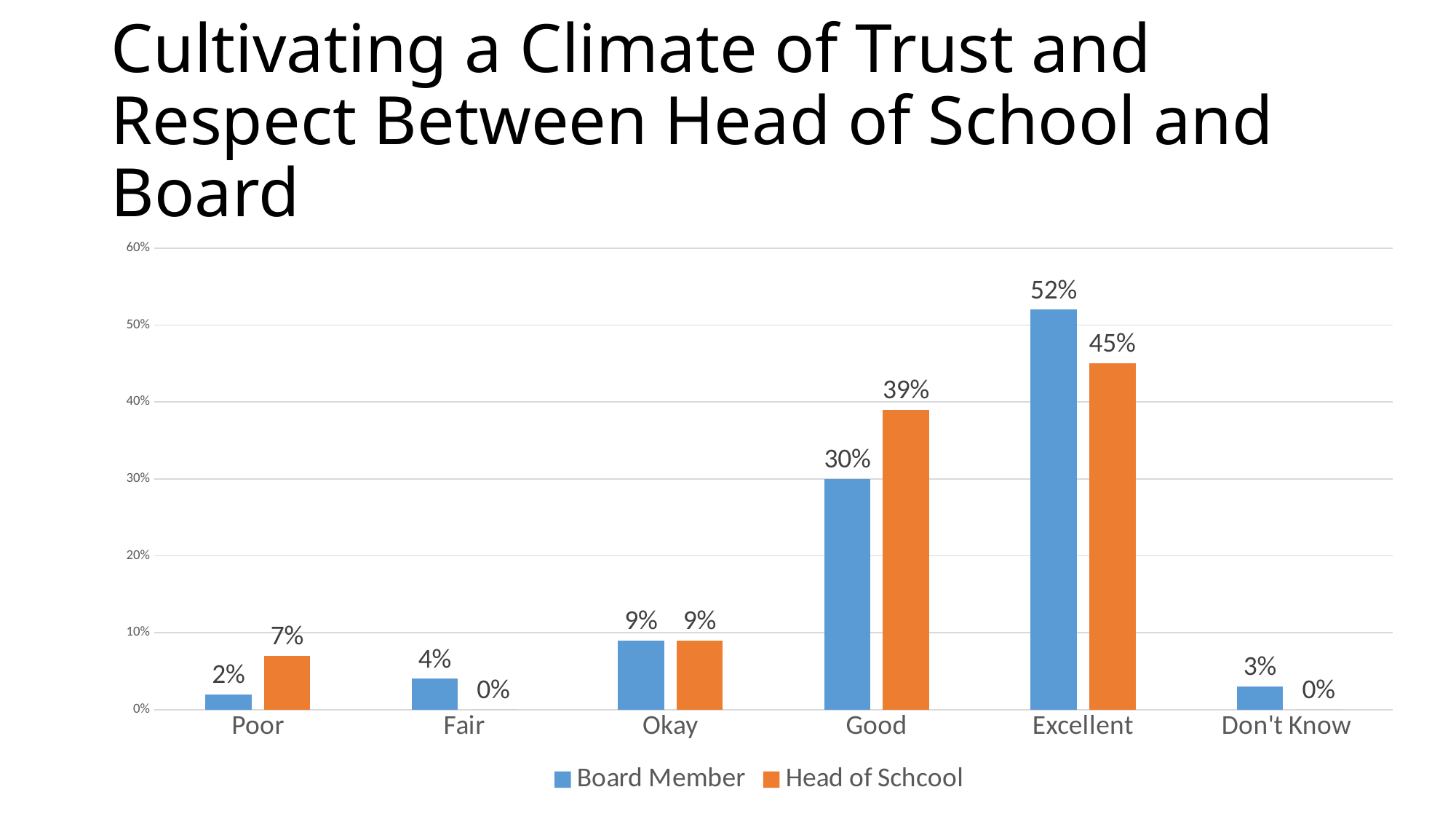
What colour are the Head of School bars? Orange Which category has the highest Head of School value? Excellent What is the Board Member value for Don't Know? 3% For the Good category, which series has the larger value, Board Member or Head of School? Head of School How many categories are shown on the x axis? 6 What percentage of Board Members rated this area as Excellent? 52% Which category has the lowest Board Member value? Poor How many series does the legend list? 2 What is the Head of School value for the Good category? 39% Is the Board Member value for Excellent greater or less than 50%? greater What kind of chart is shown on the slide? Bar chart What is the difference between the Board Member and Head of School values for Excellent? 7%